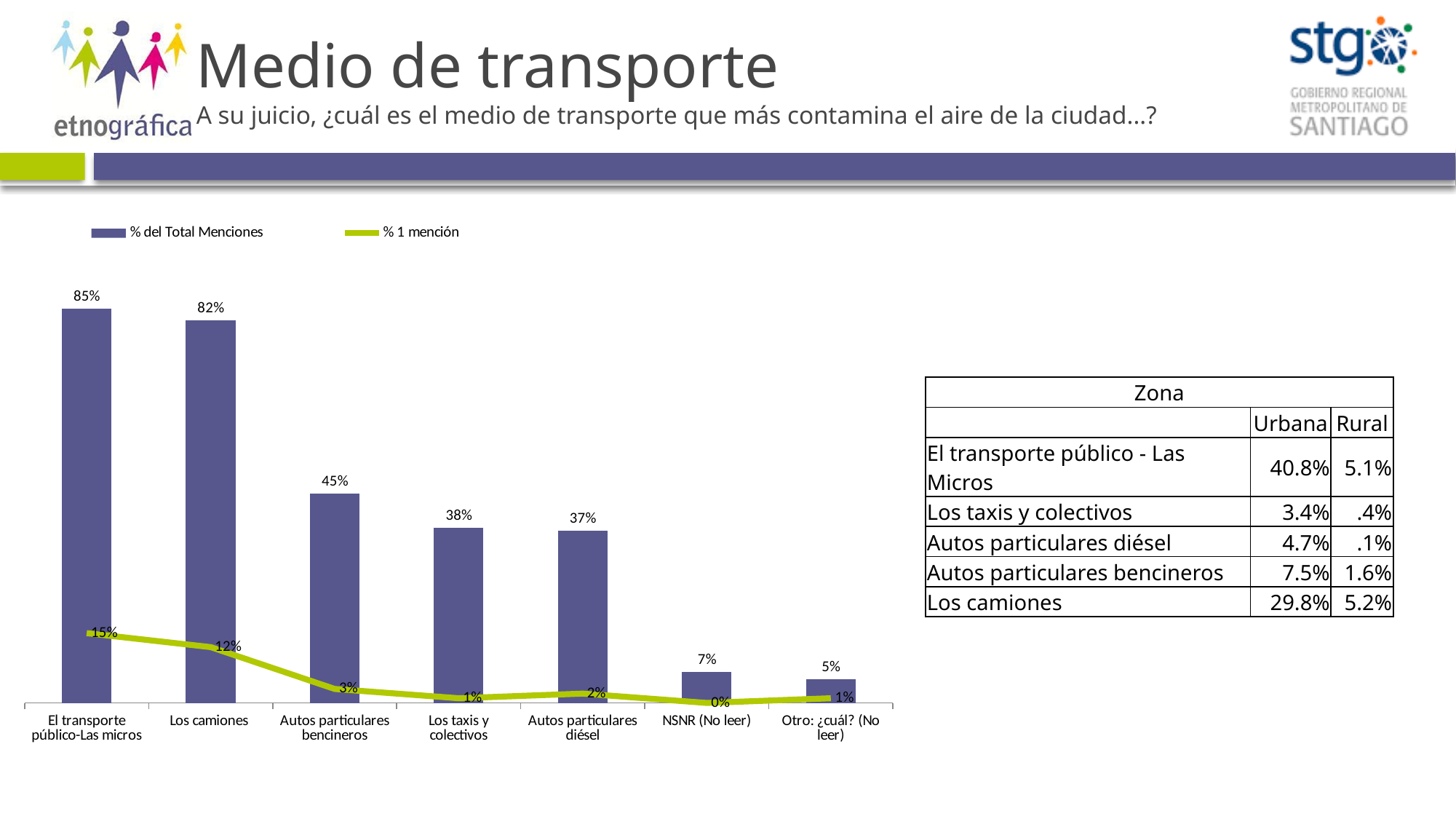
How many categories are shown on the x axis of the chart? 7 Which series is drawn as a green line in the chart? % 1 mención Which has a higher "% del Total Menciones": Los taxis y colectivos or Autos particulares diésel? Los taxis y colectivos How many series does the chart legend list? 2 What is the value of "% del Total Menciones" for Los camiones? 82% Which category has the lowest "% del Total Menciones"? Otro: ¿cuál? (No leer) What is the value of "% del Total Menciones" for Autos particulares bencineros? 45% What type of chart is used to show "% del Total Menciones"? Bar chart What is the value of "% 1 mención" for Autos particulares diésel? 2% Which category has the highest "% del Total Menciones"? El transporte público-Las micros What is the value of "% 1 mención" for El transporte público-Las micros? 15% What is the difference in "% del Total Menciones" between El transporte público-Las micros and Los camiones? 3%